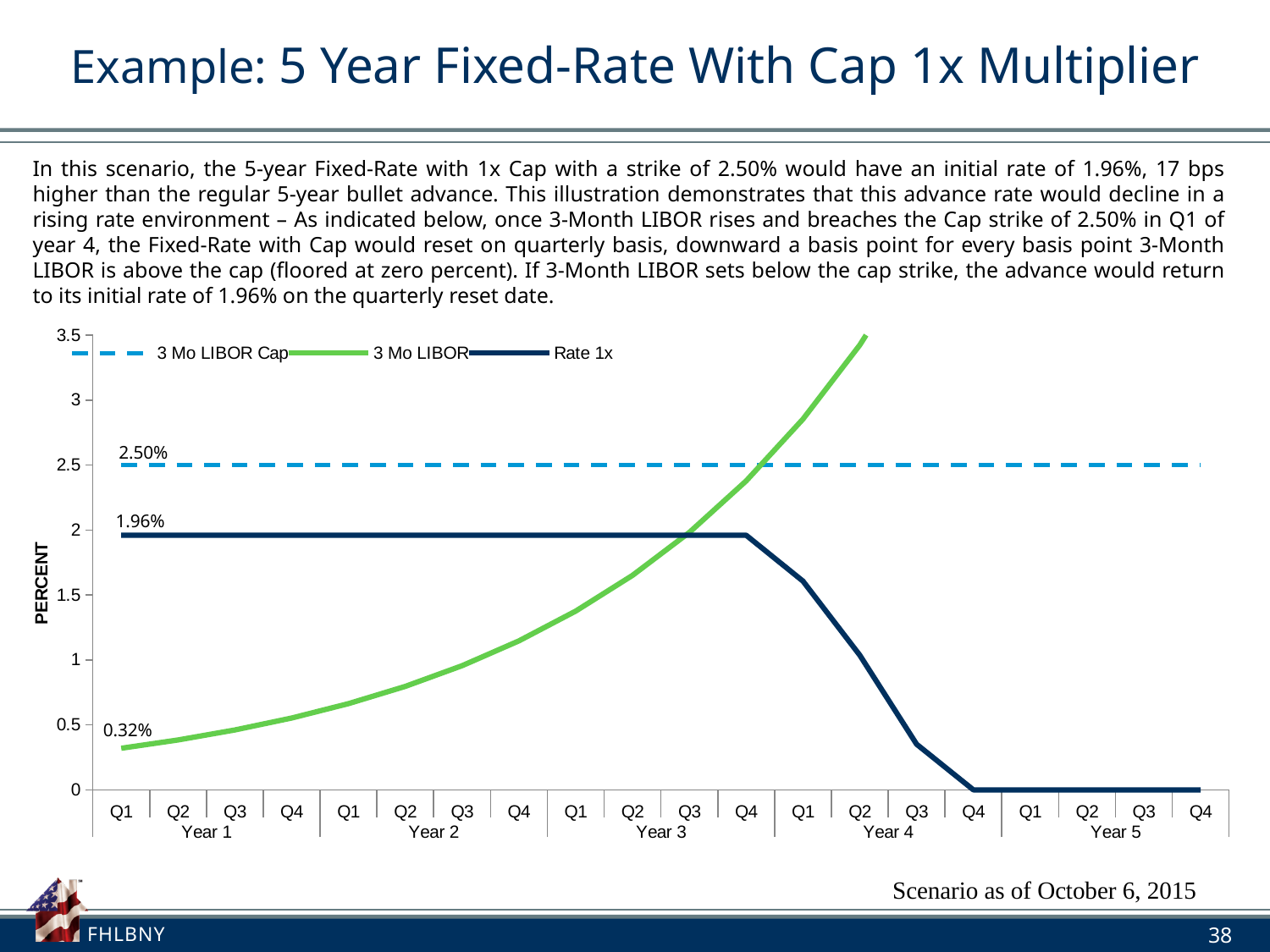
Does the Rate 1x line rise or fall during Year 4? Fall Does the 3 Mo LIBOR line rise or fall as time moves from Year 1 to Year 4? Rise What is the difference between the initial Rate 1x (1.96%) and the initial 3 Mo LIBOR (0.32%)? 1.64% What is the difference between the 3 Mo LIBOR Cap (2.50%) and the initial Rate 1x (1.96%)? 0.54% How many series does the chart legend list? 3 What is the value of Rate 1x throughout Year 5? 0 What value is labelled for the 3 Mo LIBOR Cap line? 2.50% What is the initial value labelled for the Rate 1x line in Q1 of Year 1? 1.96% What is the value labelled for 3 Mo LIBOR in Q1 of Year 1? 0.32% What type of chart is shown on the slide? Line chart Is the value of 3 Mo LIBOR in Q1 of Year 4 greater or less than 2.5? greater Is the value of Rate 1x in Q3 of Year 4 greater or less than 0.5? less